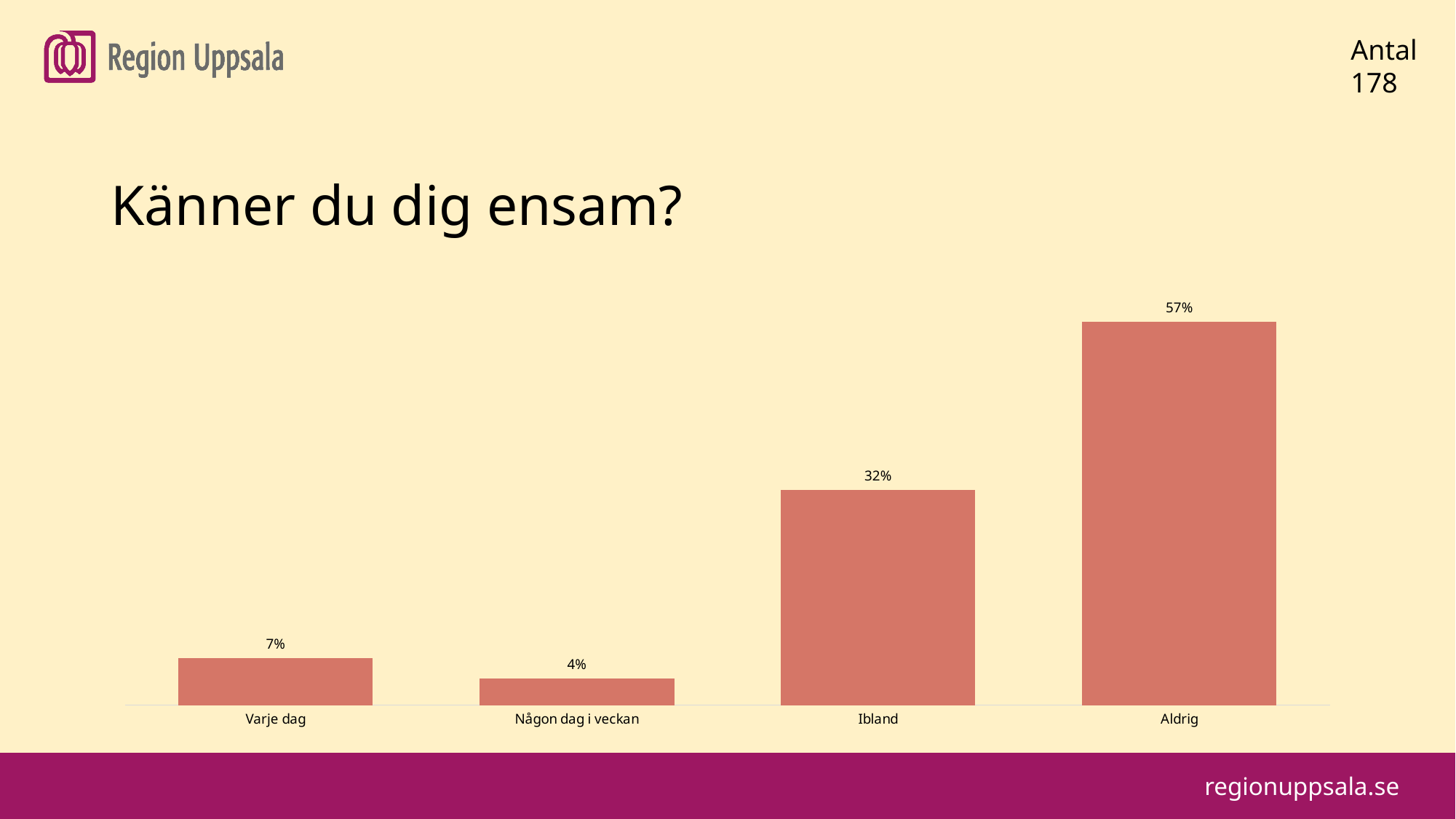
What is the value for Aldrig? 57% Which category has the highest value? Aldrig What is the value for Ibland? 32% What is the title of the slide above the chart? Känner du dig ensam? What is the value for Någon dag i veckan? 4% Which category has the lowest value? Någon dag i veckan What kind of chart is shown on the slide? Bar chart What is the difference between the values for Aldrig and Ibland? 25% How many categories are shown on the x axis? 4 What is the value for Varje dag? 7% What is the difference between the values for Varje dag and Någon dag i veckan? 3% Which is larger, the value for Ibland or the value for Varje dag? Ibland